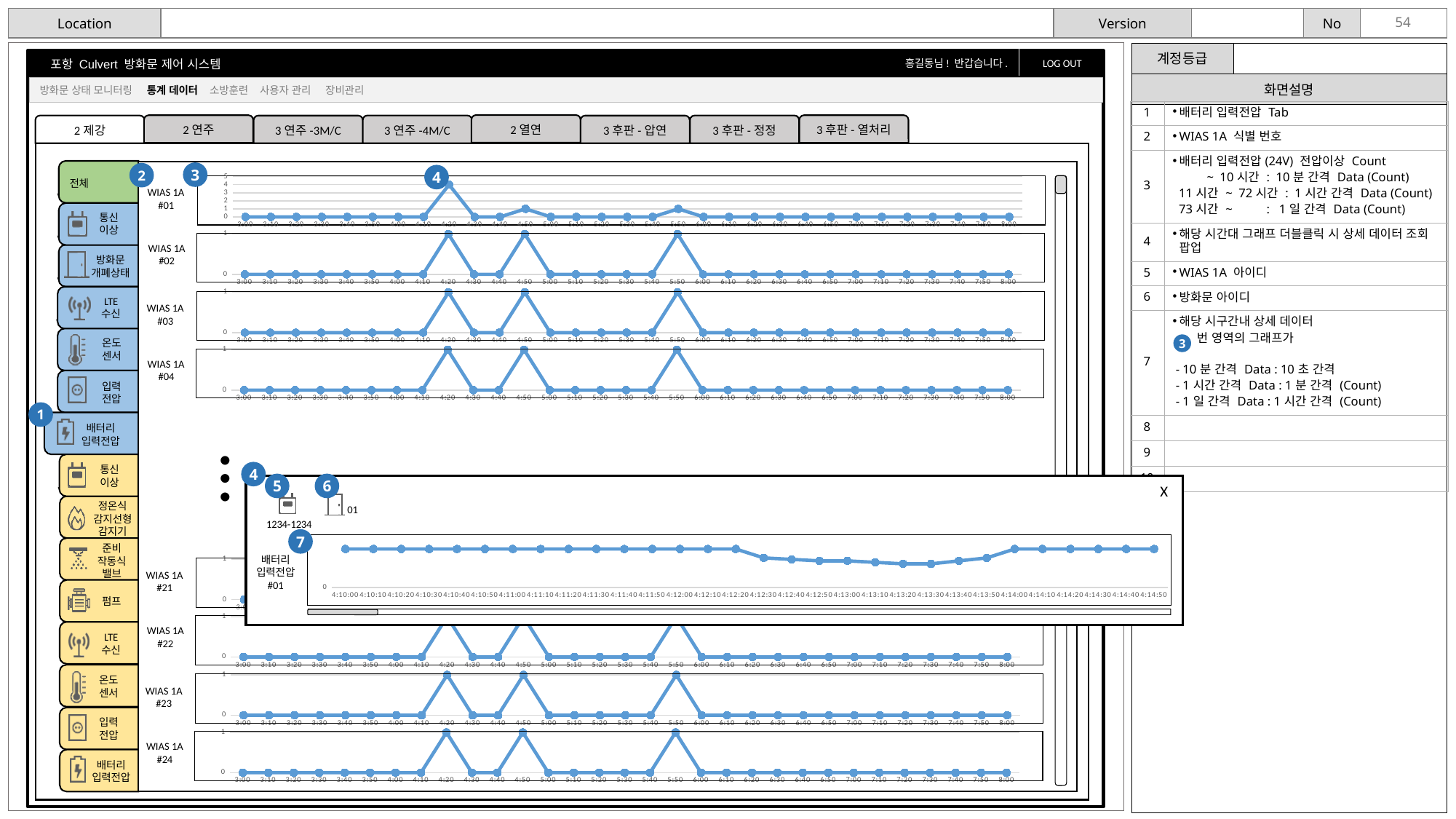
In the WIAS 1A #01 chart, which time has the larger value, 4:20 or 4:50? 4:20 In the WIAS 1A #23 chart, what is the value at 7:00? 0 In the WIAS 1A #02 chart, what is the value at 4:20? 1 What is the first time label on the x axis of the WIAS 1A #02 chart? 3:00 In the WIAS 1A #04 chart, which is larger, the value at 4:20 or the value at 6:00? 4:20 What is the label of the chart shown in the pop-up window? 배터리 입력전압 #01 In the WIAS 1A #03 chart, how many times does the line rise to 1? 3 In the WIAS 1A #24 chart, what is the value at 5:50? 1 What kind of chart is used for the WIAS 1A #02 panel? line chart In the WIAS 1A #02 chart, what is the value at 3:00? 0 In the WIAS 1A #01 chart, is the value at 4:20 greater or less than 3? greater In the WIAS 1A #02 chart, at which times does the line reach its maximum value? 4:20, 4:50, 5:50